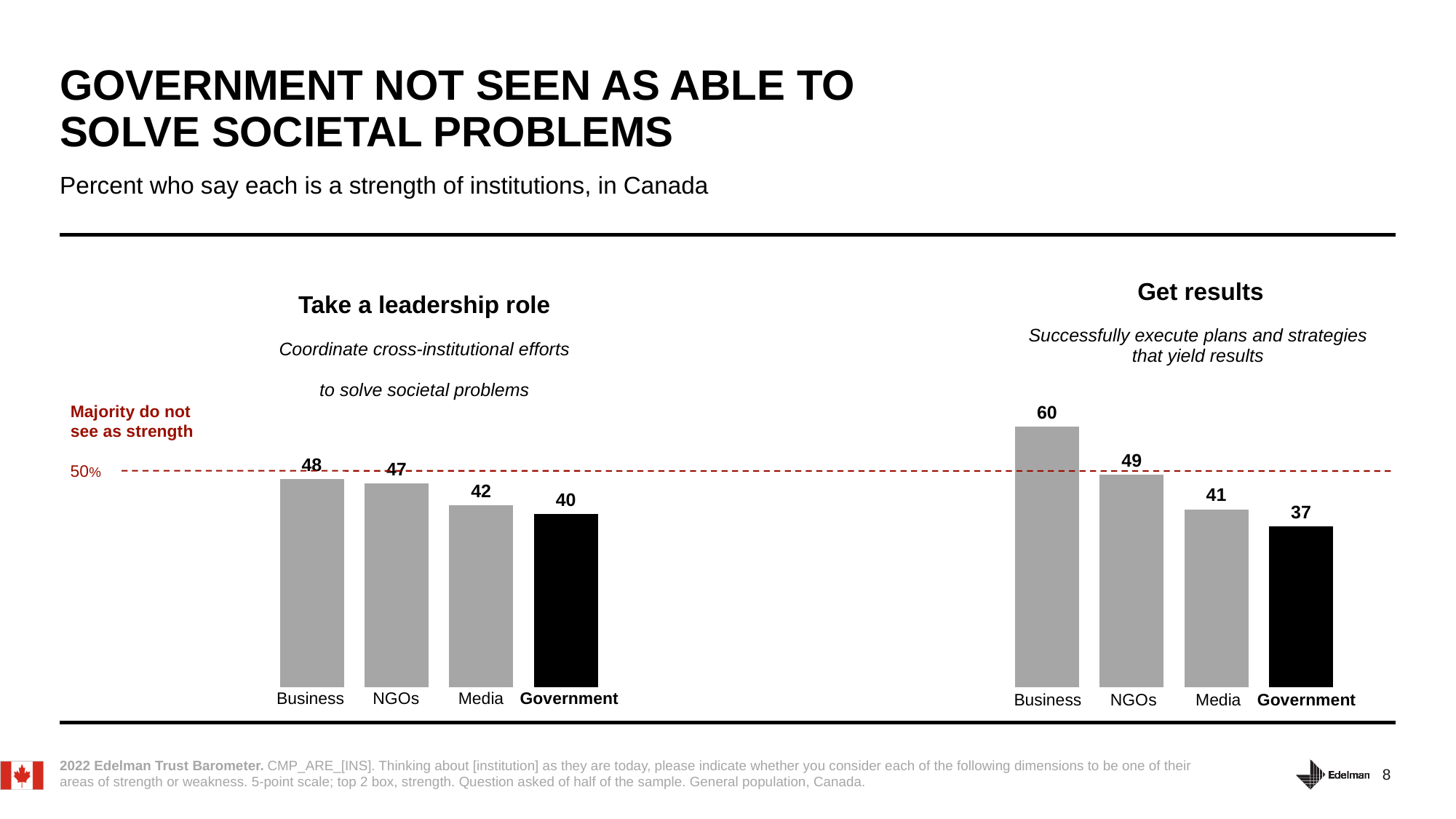
What kind of chart is the 'Take a leadership role' chart? bar chart In the 'Take a leadership role' chart, what is the difference between the values for Business and Media? 6 In the 'Get results' chart, what is the value for Media? 41 In the 'Get results' chart, which institution has the lowest value? Government In the 'Get results' chart, which is larger, the value for NGOs or the value for Media? NGOs How many institutions are shown in the 'Get results' chart? 4 In the 'Take a leadership role' chart, what is the value for Government? 40 In the 'Take a leadership role' chart, is the value for Government greater or less than 50%? less In the 'Get results' chart, what is the value for Business? 60 In the 'Get results' chart, what is the difference between the values for Business and Government? 23 In the 'Get results' chart, which bar is coloured black? Government In the 'Take a leadership role' chart, which institution has the highest value? Business